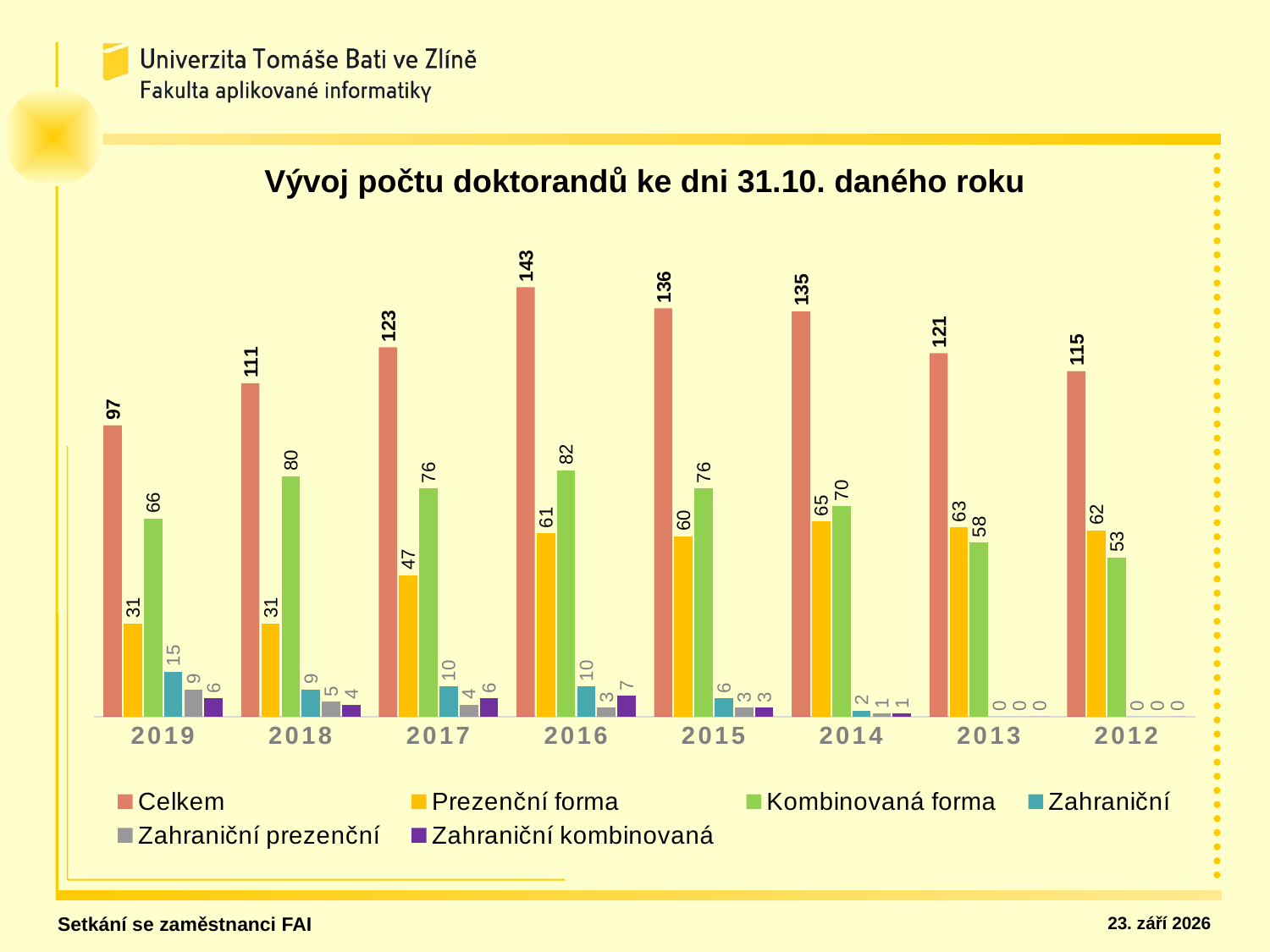
In which year is Celkem highest? 2016 What is the value of Zahraniční for 2019? 15 How many years are shown on the x axis? 8 What is the value of Celkem for 2016? 143 What kind of chart is shown on the slide? Bar chart What is the value of Kombinovaná forma for 2018? 80 How many series does the legend list? 6 In 2014, which is larger: Prezenční forma or Kombinovaná forma? Kombinovaná forma Moving from 2016 to 2012 along the x axis, does Kombinovaná forma rise or fall? Fall What is the title of the chart? Vývoj počtu doktorandů ke dni 31.10. daného roku What is the difference between Celkem in 2016 and Celkem in 2019? 46 In which year is Celkem lowest? 2019